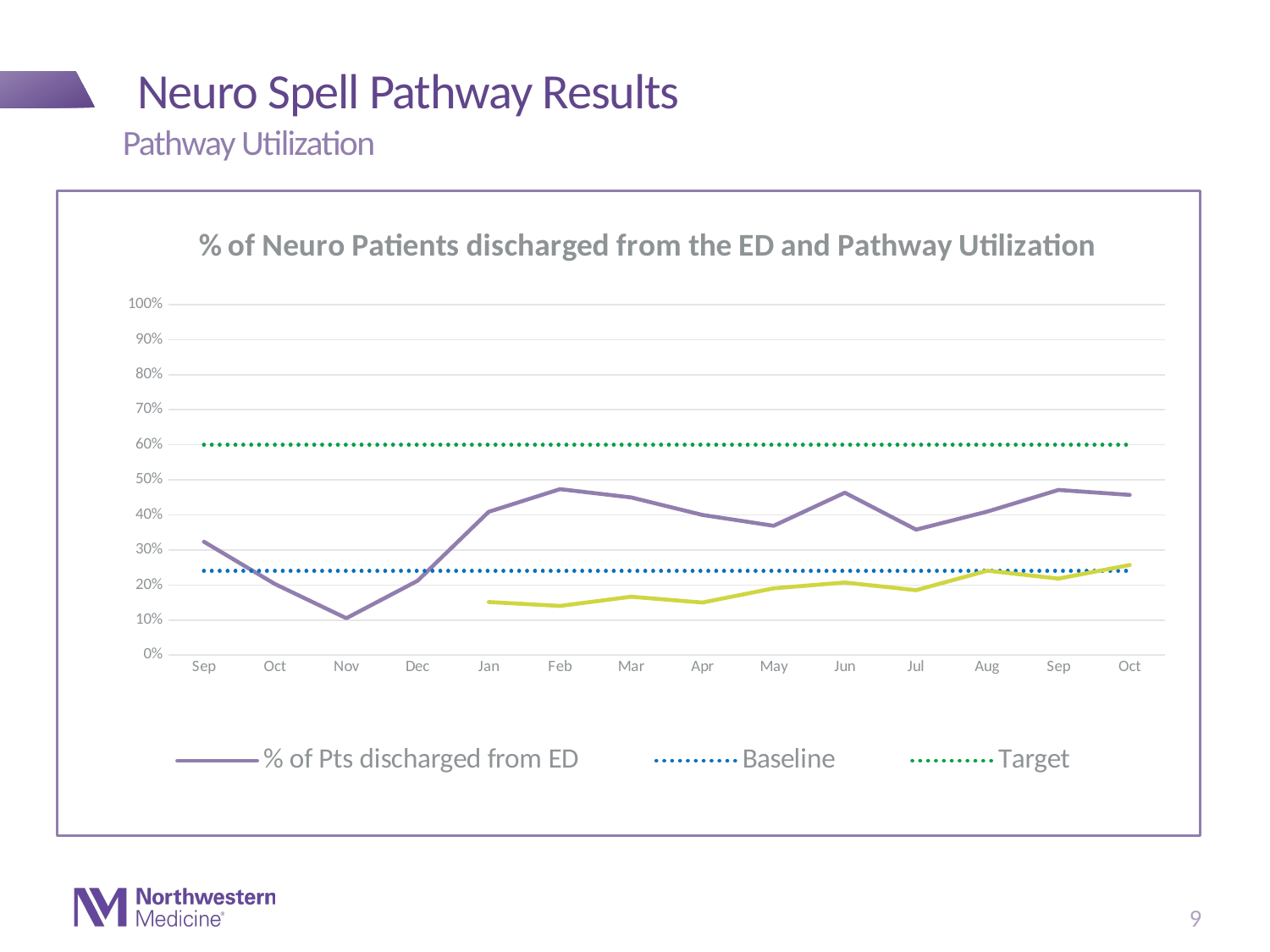
What value does the Target line sit at? 60% In which month is the % of Pts discharged from ED lowest? Nov Does the % of Pts discharged from ED rise or fall from Sep to Nov? fall How many series does the chart legend list? 3 Which month has a higher % of Pts discharged from ED, Jun or Jul? Jun Is the % of Pts discharged from ED in Nov greater or less than 20%? less Is the % of Pts discharged from ED in Feb greater or less than 40%? greater Is the % of Pts discharged from ED in Dec greater or less than 30%? less What kind of chart is shown on the slide? line chart How many months are shown along the x axis of the chart? 14 What is the title of the chart? % of Neuro Patients discharged from the ED and Pathway Utilization